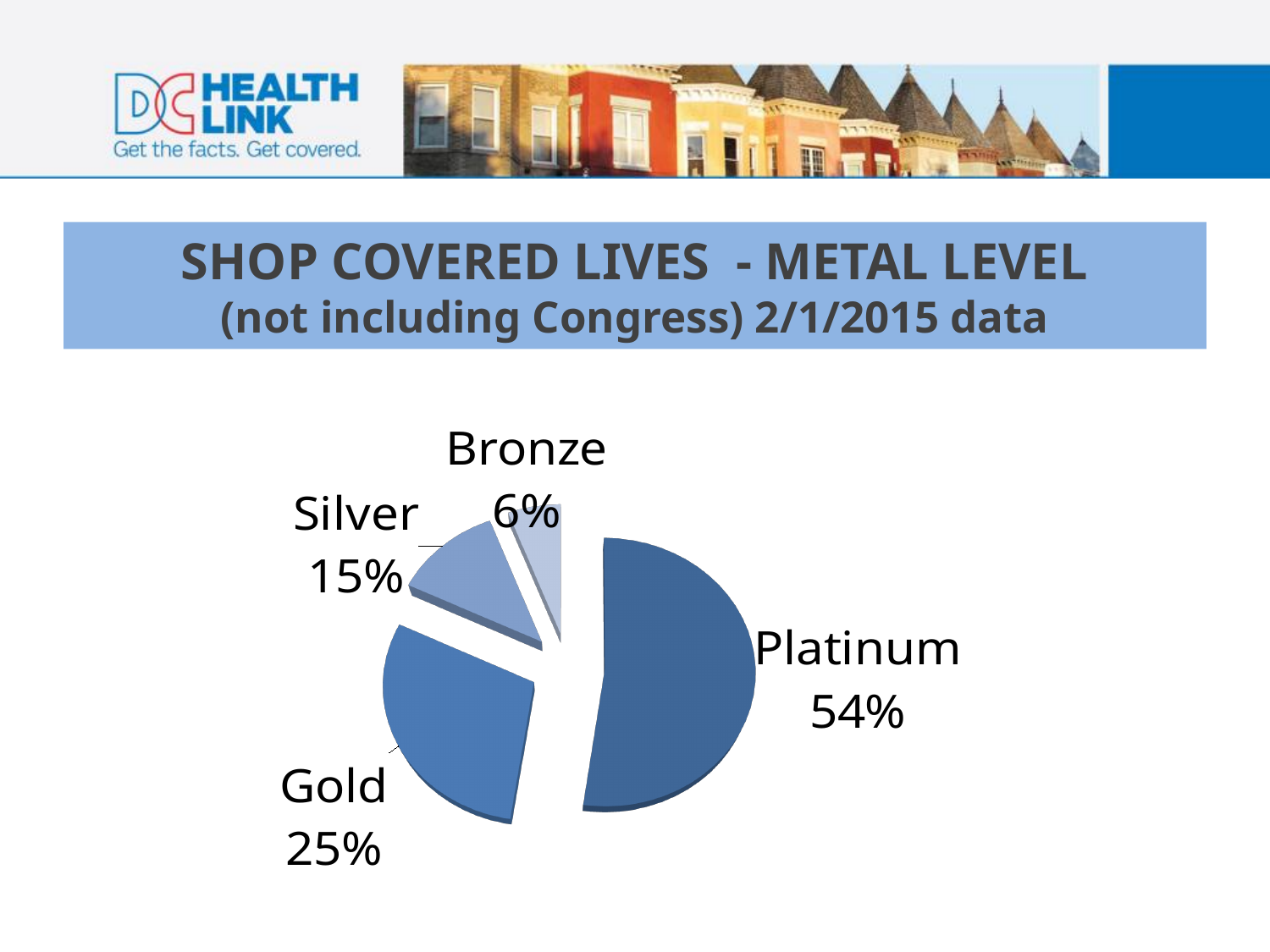
What share of SHOP covered lives is at the Silver metal level? 15% What share of SHOP covered lives is at the Gold metal level? 25% How many percentage points larger is the Platinum share than the Gold share? 29 Which metal level has the smallest share of SHOP covered lives? Bronze What share of SHOP covered lives is at the Bronze metal level? 6% How many percentage points larger is the Silver share than the Bronze share? 9 Which has a larger share of SHOP covered lives, Gold or Silver? Gold How many metal levels are shown in the pie chart? 4 What kind of chart is shown on the slide? Pie chart What share of SHOP covered lives is at the Platinum metal level? 54% Which metal level has the largest share of SHOP covered lives? Platinum What is the title of the chart on the slide? SHOP COVERED LIVES - METAL LEVEL (not including Congress) 2/1/2015 data